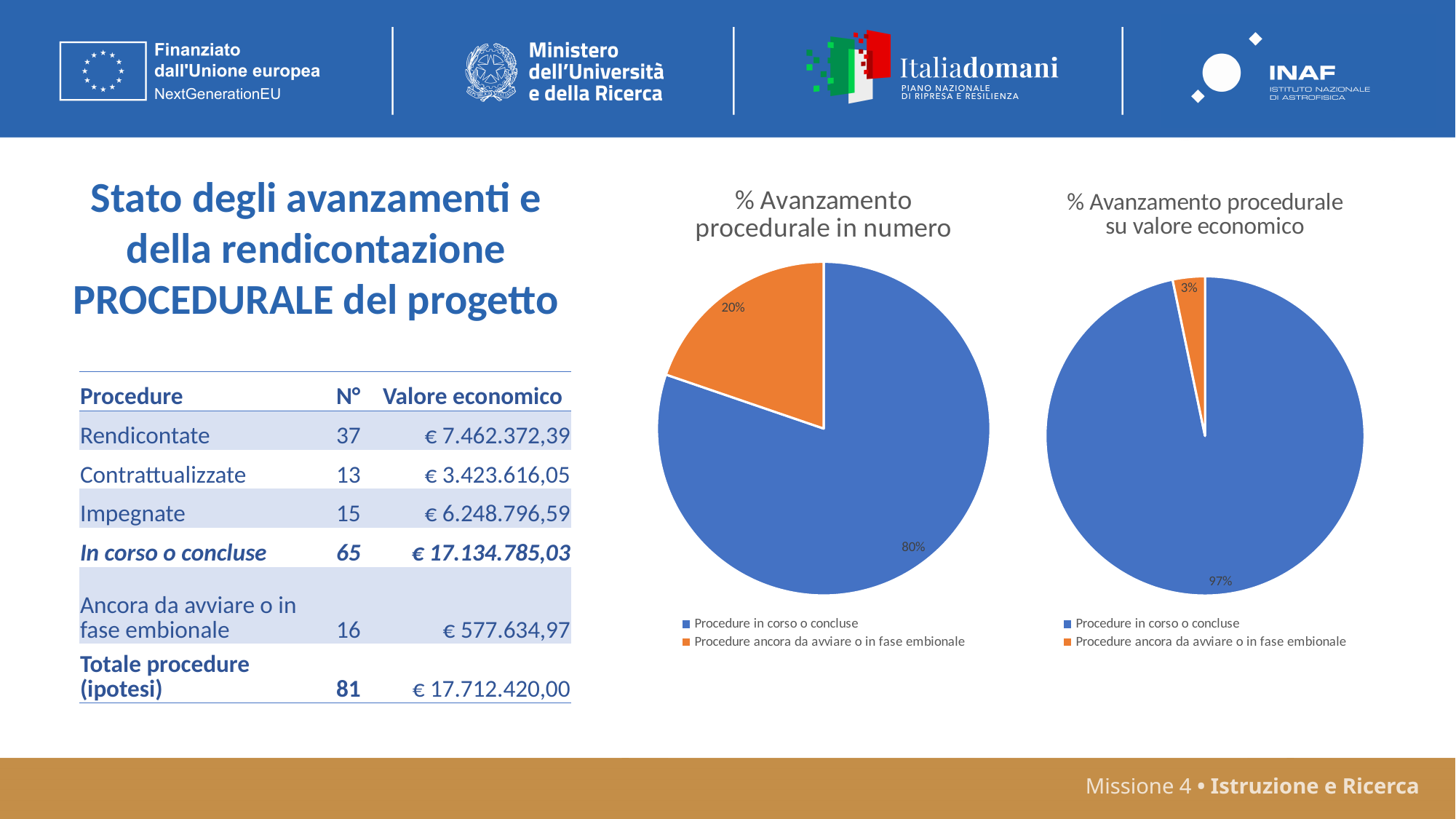
In the chart titled '% Avanzamento procedurale su valore economico', what share of the pie is 'Procedure in corso o concluse'? 97% Which is larger: the 'Procedure ancora da avviare o in fase embrionale' slice in the chart '% Avanzamento procedurale in numero' or the same slice in the chart '% Avanzamento procedurale su valore economico'? % Avanzamento procedurale in numero In the chart titled '% Avanzamento procedurale in numero', what is the difference in percentage points between the two slices? 60 In the chart titled '% Avanzamento procedurale in numero', what colour is the slice for 'Procedure ancora da avviare o in fase embrionale'? Orange What type of chart is '% Avanzamento procedurale in numero'? Pie chart In the chart titled '% Avanzamento procedurale su valore economico', what share of the pie is 'Procedure ancora da avviare o in fase embrionale'? 3% In the chart titled '% Avanzamento procedurale in numero', what share of the pie is 'Procedure in corso o concluse'? 80% In the chart titled '% Avanzamento procedurale in numero', which category has the largest slice? Procedure in corso o concluse How many categories does the chart titled '% Avanzamento procedurale su valore economico' show? 2 In the chart titled '% Avanzamento procedurale su valore economico', which category has the smallest slice? Procedure ancora da avviare o in fase embionale In the chart titled '% Avanzamento procedurale su valore economico', what is the difference in percentage points between the two slices? 94